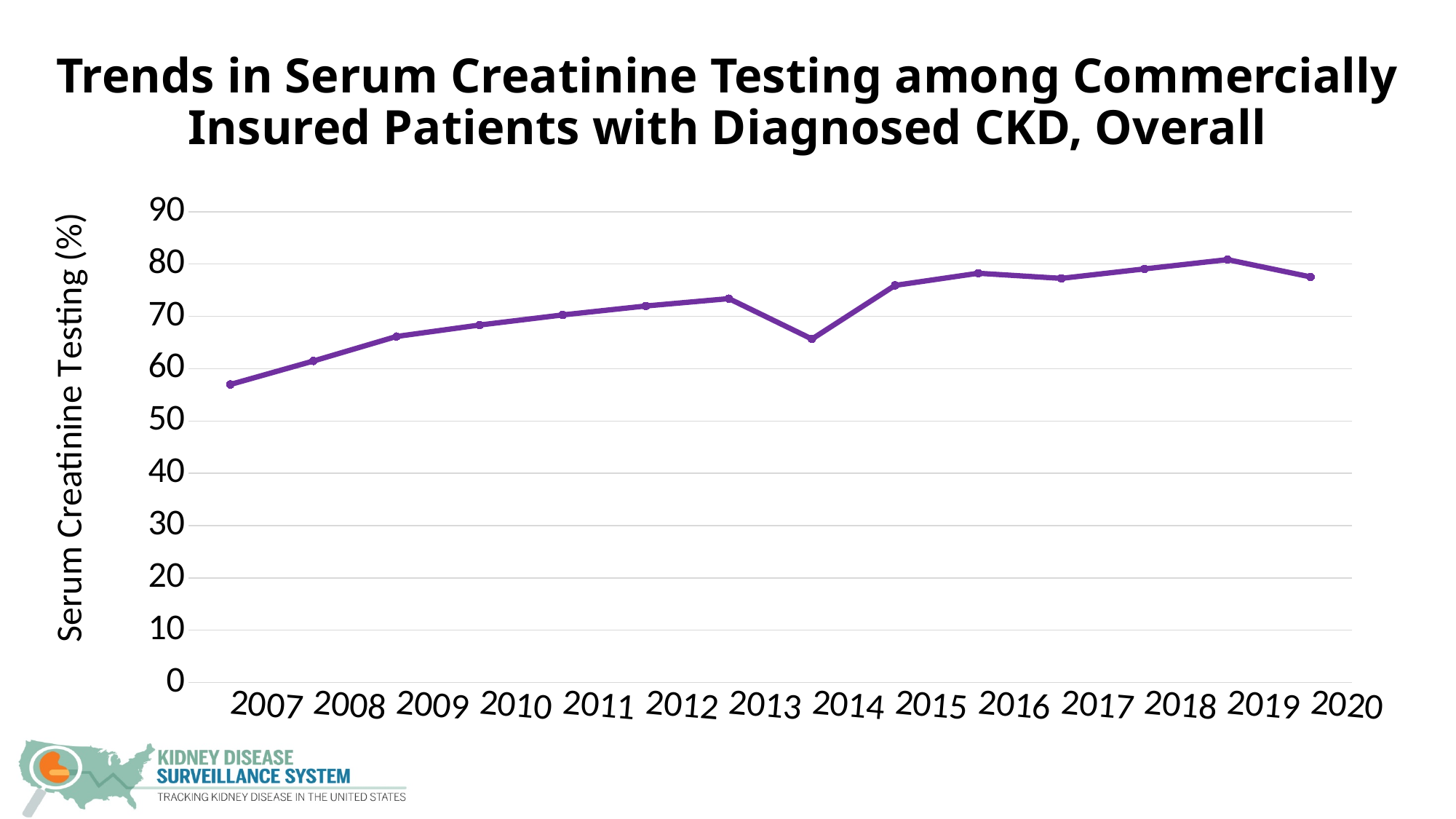
Which year has a higher value, 2007 or 2020? 2020 Which year has the lowest serum creatinine testing percentage? 2007 What type of chart is shown on the slide? Line chart Is the value for 2007 greater or less than 60? less Do the values rise or fall from 2007 to 2013? Rise How many years are plotted on the x axis? 14 Which year has the highest serum creatinine testing percentage? 2019 What is the label of the y axis? Serum Creatinine Testing (%) Is the value for 2014 greater or less than 70? less Which year has a higher value, 2013 or 2014? 2013 Is the value for 2013 greater or less than 70? greater